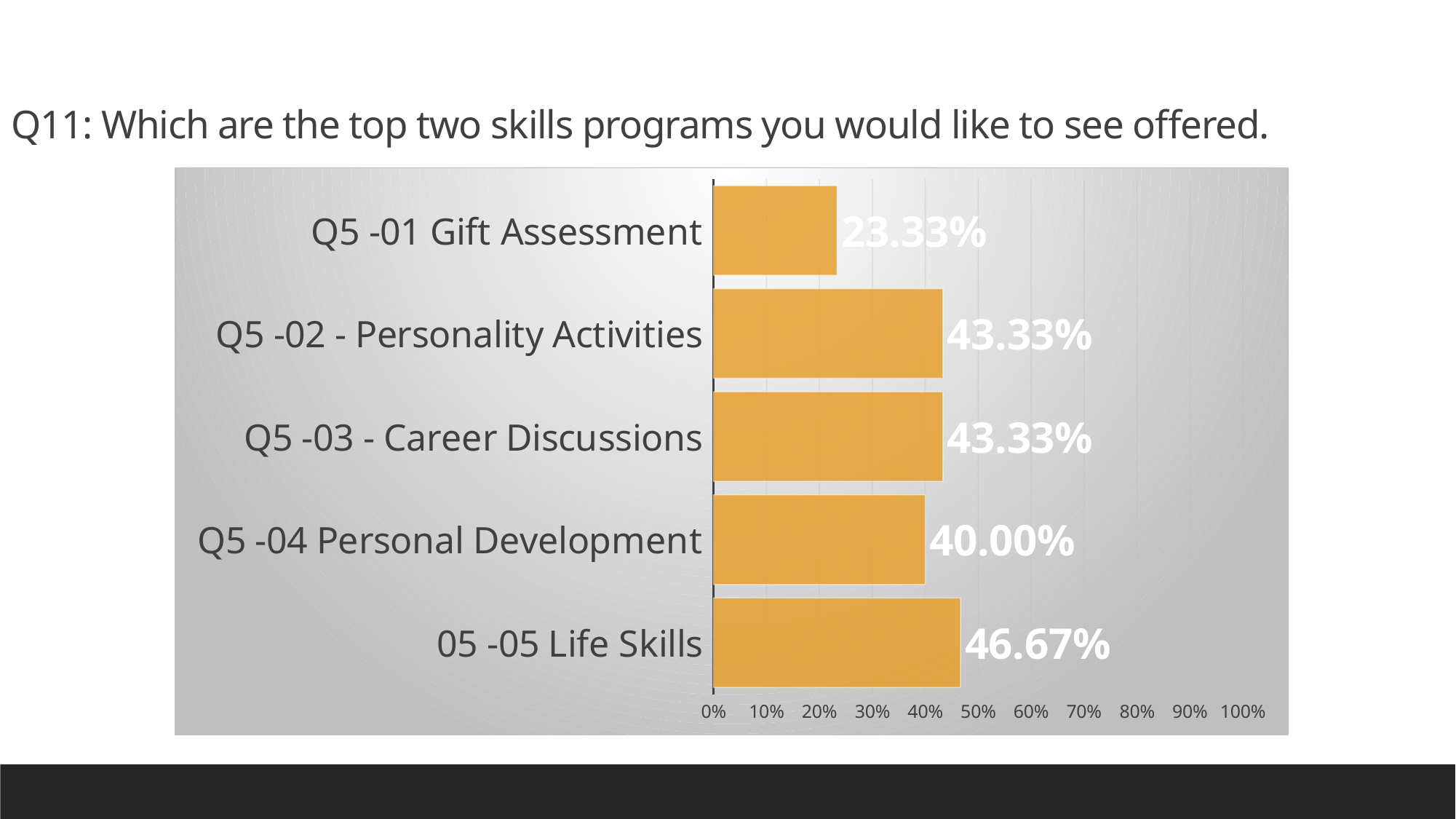
Which is larger, the value for Q5 -04 Personal Development or the value for Q5 -01 Gift Assessment? Q5 -04 Personal Development What is the value for Q5 -03 - Career Discussions? 43.33% What is the value for 05 -05 Life Skills? 46.67% What is the maximum value shown on the horizontal axis? 100% What kind of chart is shown on the slide? Bar chart Which category has the highest value? 05 -05 Life Skills Which category has the lowest value? Q5 -01 Gift Assessment What is the difference between the values for 05 -05 Life Skills and Q5 -01 Gift Assessment? 23.34% How many categories are shown in the chart? 5 What is the difference between the values for Q5 -02 - Personality Activities and Q5 -04 Personal Development? 3.33% What is the value for Q5 -01 Gift Assessment? 23.33% What is the value for Q5 -04 Personal Development? 40.00%